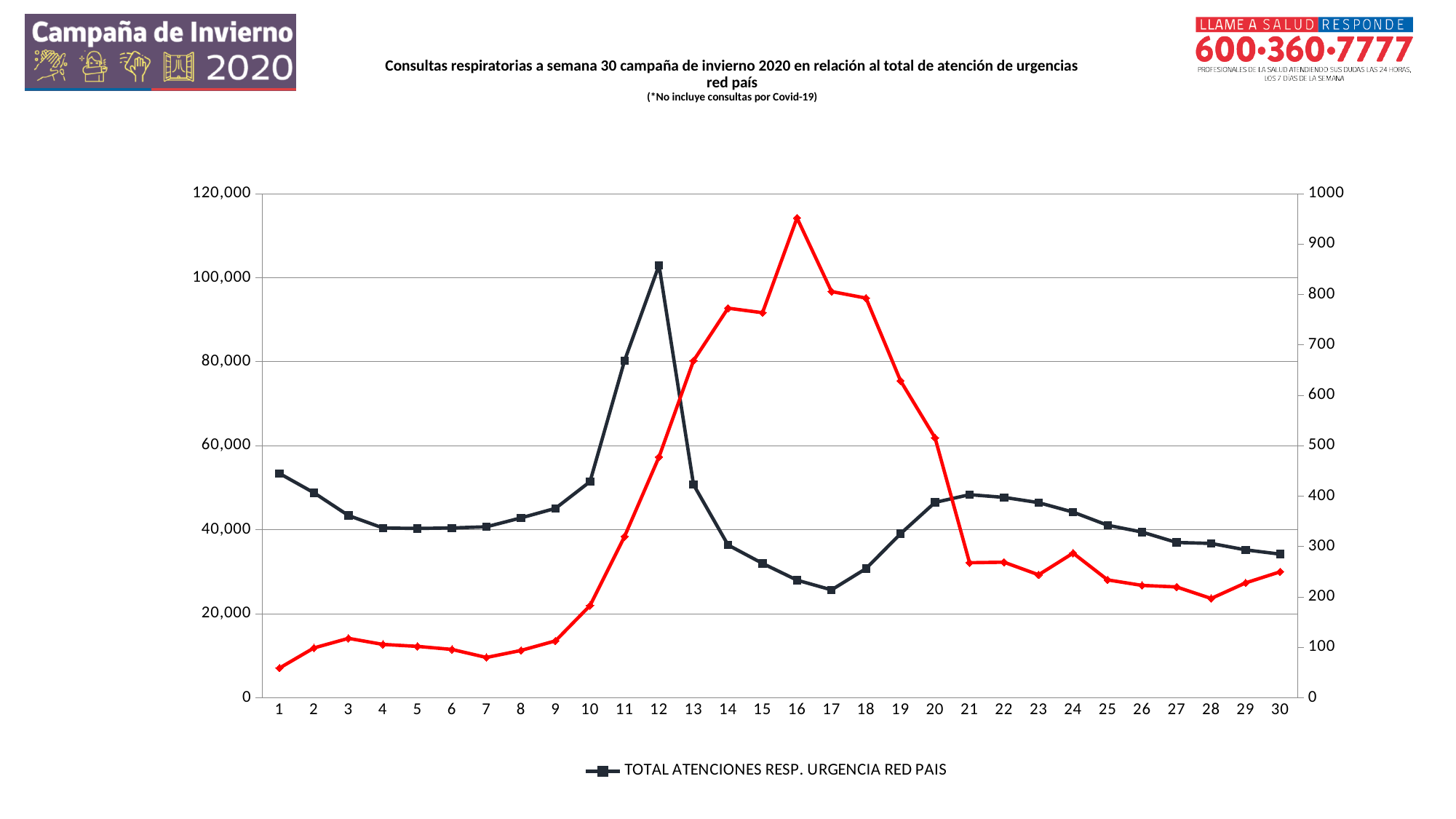
How many weeks (points) are plotted along the x axis? 30 Which is larger for the dark line: the value at week 2 or the value at week 30? week 2 At which week does the dark line (TOTAL ATENCIONES RESP. URGENCIA RED PAIS) reach its lowest value? 17 What is the series name shown in the legend? TOTAL ATENCIONES RESP. URGENCIA RED PAIS What kind of chart is shown on the slide? line chart Is the value of the dark line at week 12 greater or less than 100,000 on the left axis? greater At which week does the dark line (TOTAL ATENCIONES RESP. URGENCIA RED PAIS) reach its highest value? 12 At which week does the red line reach its highest value? 16 Does the dark line rise or fall from week 21 to week 30? fall Is the value of the dark line at week 17 greater or less than 40,000 on the left axis? less Is the value of the red line at week 16 greater or less than 900 on the right axis? greater How many series does the legend list? 1